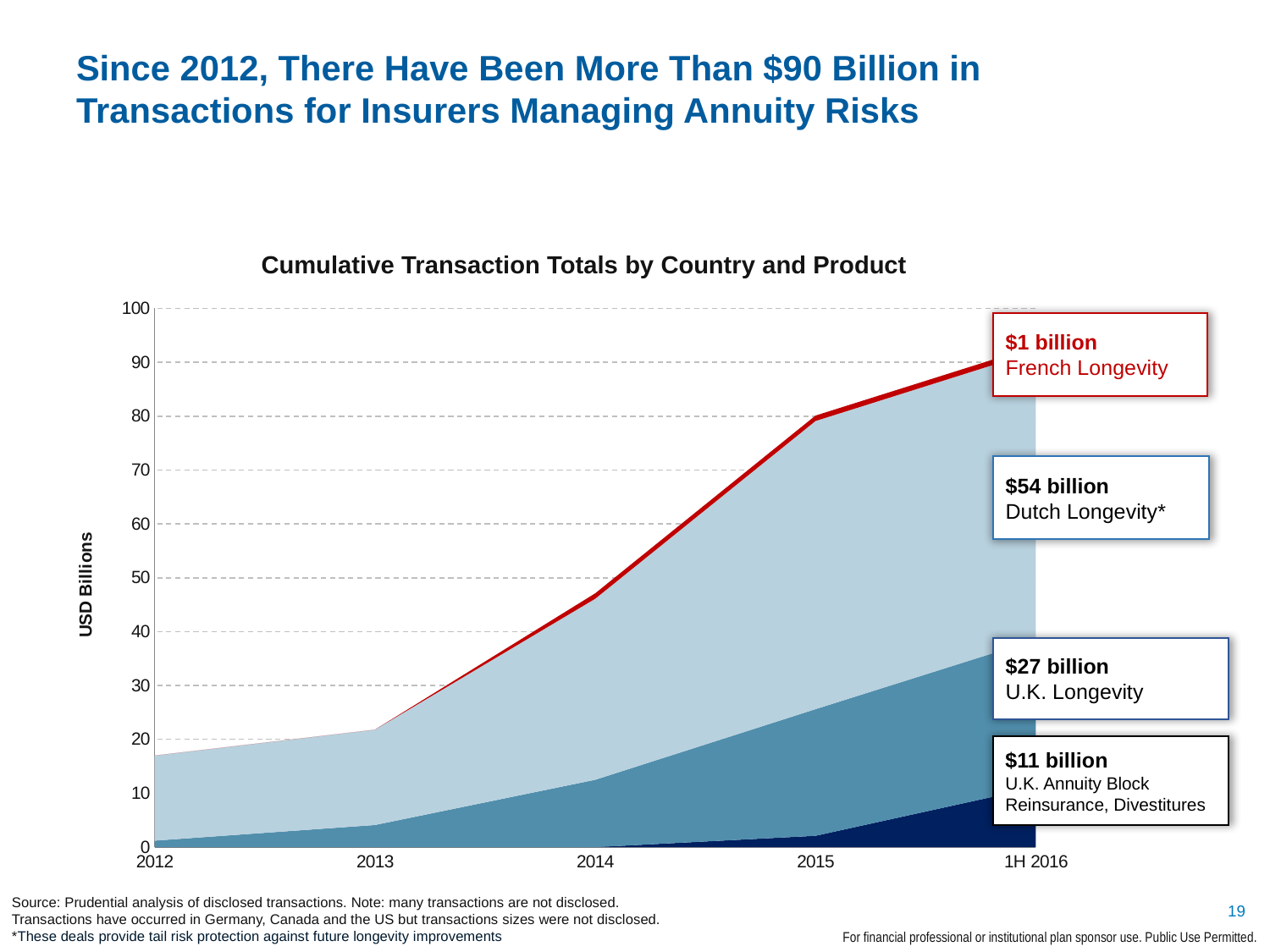
Which product category has the largest cumulative transaction total according to the callouts? Dutch Longevity Is the total cumulative transaction value in 2012 greater or less than 20 USD billions? less What is the cumulative transaction total for U.K. Annuity Block Reinsurance, Divestitures shown in the callout? $11 billion What is the cumulative transaction total for U.K. Longevity shown in the callout? $27 billion What is the sum of the four cumulative transaction totals shown in the callouts? $93 billion What is the cumulative transaction total for French Longevity shown in the callout? $1 billion What kind of chart is shown on the slide? Stacked area chart What is the cumulative transaction total for Dutch Longevity shown in the callout? $54 billion What is the title of the chart? Cumulative Transaction Totals by Country and Product How many time periods are labeled on the x axis? 5 Which product category has the smallest cumulative transaction total according to the callouts? French Longevity What is the difference between the Dutch Longevity total and the U.K. Longevity total shown in the callouts? $27 billion